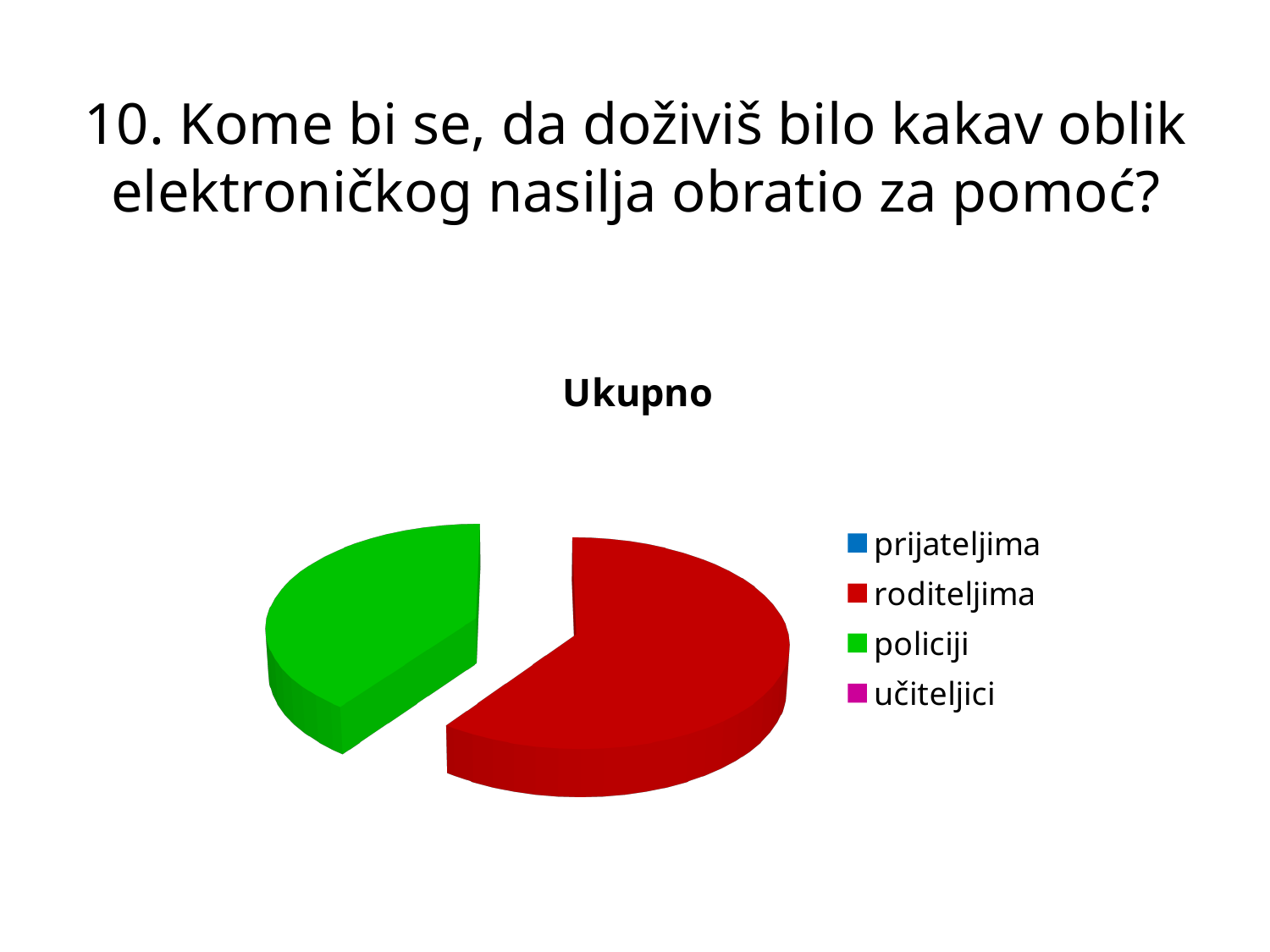
Which colour represents policiji in the chart? green How many slices are visibly drawn in the pie? 2 Which slice is larger, roditeljima or policiji? roditeljima Which category has the largest slice of the pie? roditeljima What kind of chart is shown on the slide? pie chart Which category is shown in red in the pie chart? roditeljima What is the title of the chart? Ukupno How many entries does the chart's legend list? 4